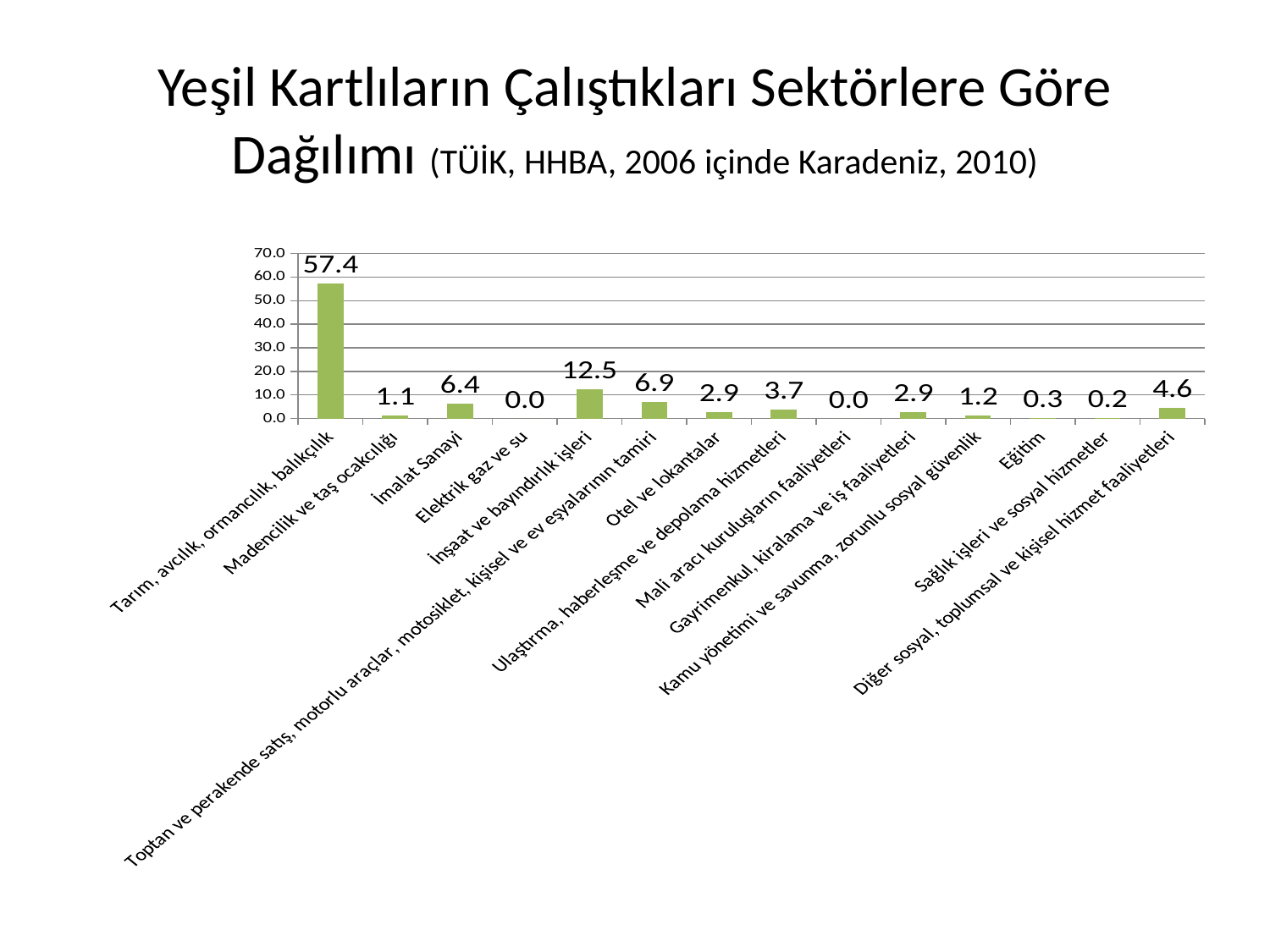
What kind of chart is shown on the slide? bar chart Which is larger, the value for İmalat Sanayi or the value for Otel ve lokantalar? İmalat Sanayi Is the value for Tarım, avcılık, ormancılık, balıkçılık greater or less than 50.0? greater What is the value for Ulaştırma, haberleşme ve depolama hizmetleri? 3.7 What is the difference between the values for Tarım, avcılık, ormancılık, balıkçılık and İnşaat ve bayındırlık işleri? 44.9 What is the value for Tarım, avcılık, ormancılık, balıkçılık? 57.4 What is the value for İnşaat ve bayındırlık işleri? 12.5 What is the value for Diğer sosyal, toplumsal ve kişisel hizmet faaliyetleri? 4.6 What is the value for İmalat Sanayi? 6.4 Which category has the highest value? Tarım, avcılık, ormancılık, balıkçılık What is the value for Eğitim? 0.3 How many categories are shown on the x axis? 14